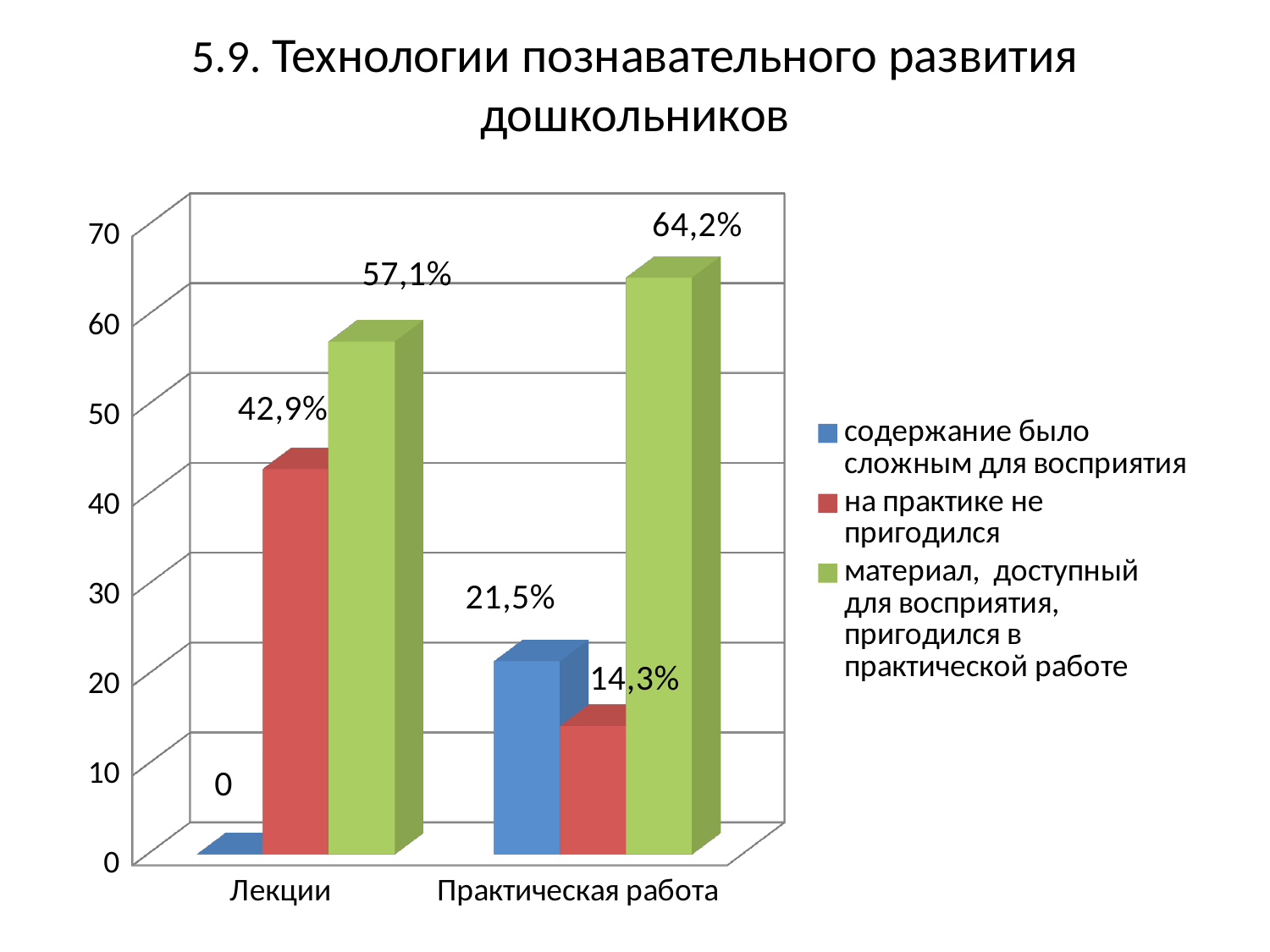
What is the value for "содержание было сложным для восприятия" in the "Практическая работа" category? 21,5% What colour are the bars for "на практике не пригодился"? red How many series does the legend list? 3 How many categories are shown on the x axis? 2 Which series has the lowest value in the "Лекции" category? содержание было сложным для восприятия What is the difference between the "материал, доступный для восприятия, пригодился в практической работе" values for "Практическая работа" and "Лекции"? 7,1% Which is larger: the "на практике не пригодился" value for "Лекции" or for "Практическая работа"? Лекции What is the value for "на практике не пригодился" in the "Лекции" category? 42,9% What is the value for "содержание было сложным для восприятия" in the "Лекции" category? 0 What kind of chart is shown on the slide? bar chart What is the value for "материал, доступный для восприятия, пригодился в практической работе" in the "Практическая работа" category? 64,2% Which series has the highest value in the "Практическая работа" category? материал, доступный для восприятия, пригодился в практической работе